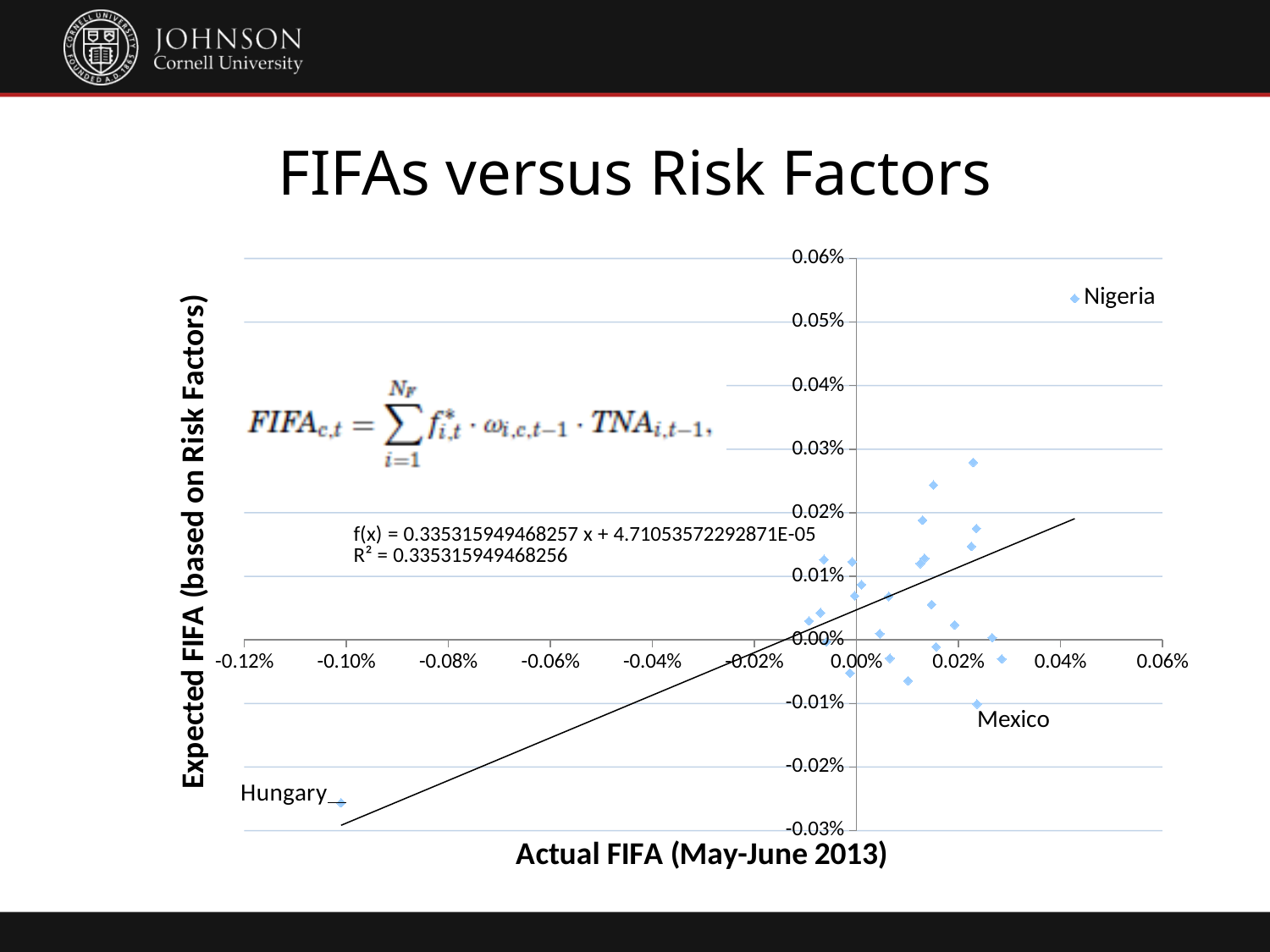
Which has a higher Expected FIFA value, Mexico or Nigeria? Nigeria What R² value is printed on the chart? 0.335315949468256 What is the title of the chart? FIFAs versus Risk Factors Is the Expected FIFA value for Hungary greater or less than -0.02%? less Is the Actual FIFA value for Hungary greater or less than -0.08%? less What kind of chart is shown on the slide? scatter chart Which labeled country has the lowest Actual FIFA value? Hungary What is the label of the x axis? Actual FIFA (May-June 2013) Does the fitted trendline rise or fall as Actual FIFA increases? rises Which labeled country has the highest Expected FIFA value? Nigeria Is the Expected FIFA value for Nigeria greater or less than 0.04%? greater